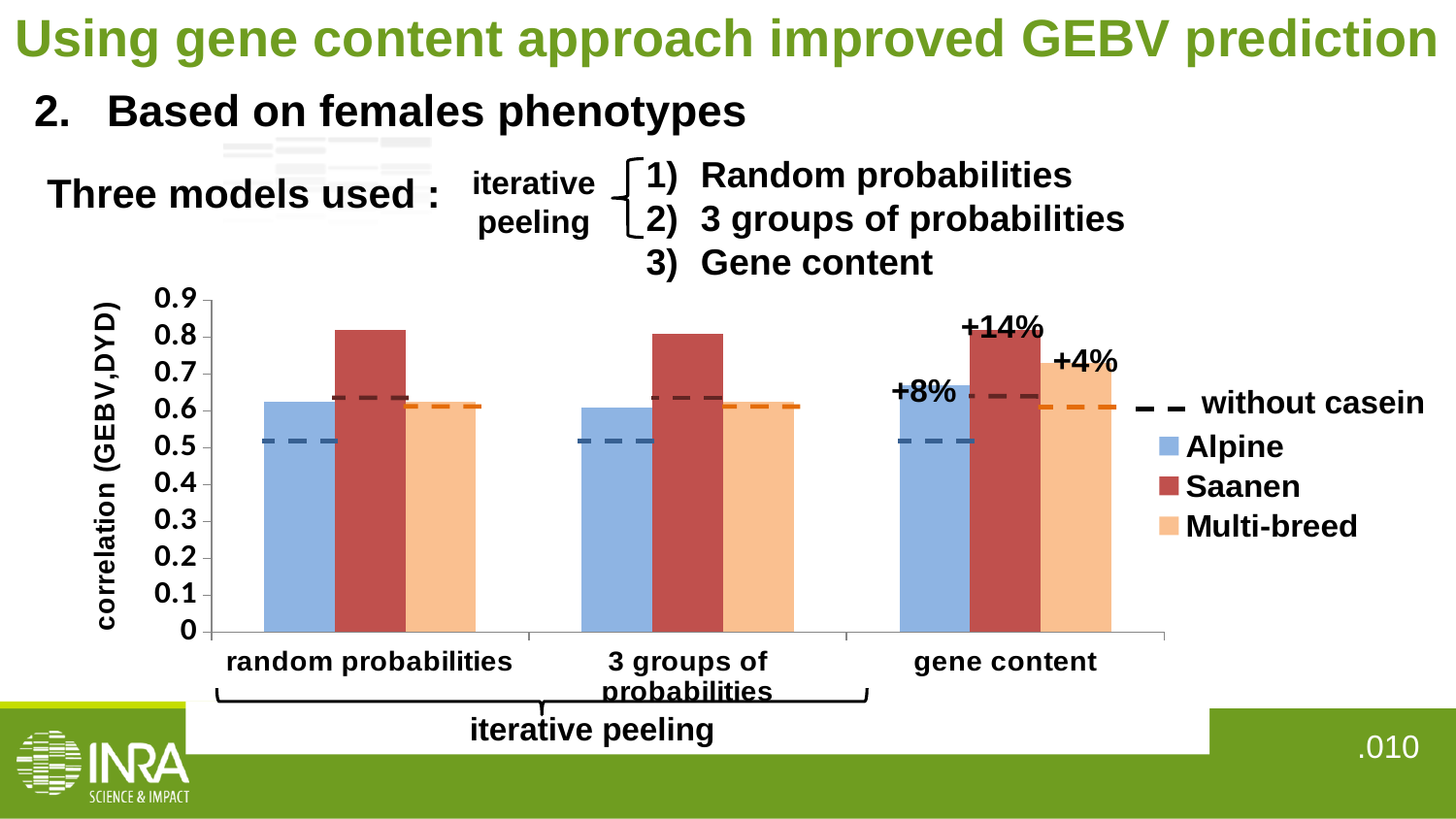
Which series has the lowest bar in the 'gene content' category? Alpine Is the Alpine value for 'random probabilities' greater or less than 0.7? less In the 'gene content' category, is the Saanen bar or the Alpine bar taller? Saanen What percentage label is printed above the Saanen bar in the 'gene content' category? +14% Is the Saanen value for 'gene content' greater or less than 0.8? greater Which series has the highest bar in the 'random probabilities' category? Saanen What percentage label is printed next to the Alpine bar in the 'gene content' category? +8% How many breed series does the chart's legend list (excluding the dashed 'without casein' line)? 3 Is the Multi-breed value for 'gene content' greater or less than 0.6? greater What is the title of the chart's y axis? correlation (GEBV,DYD) What kind of chart is shown on the slide? bar chart How many categories are shown on the x axis of the chart? 3